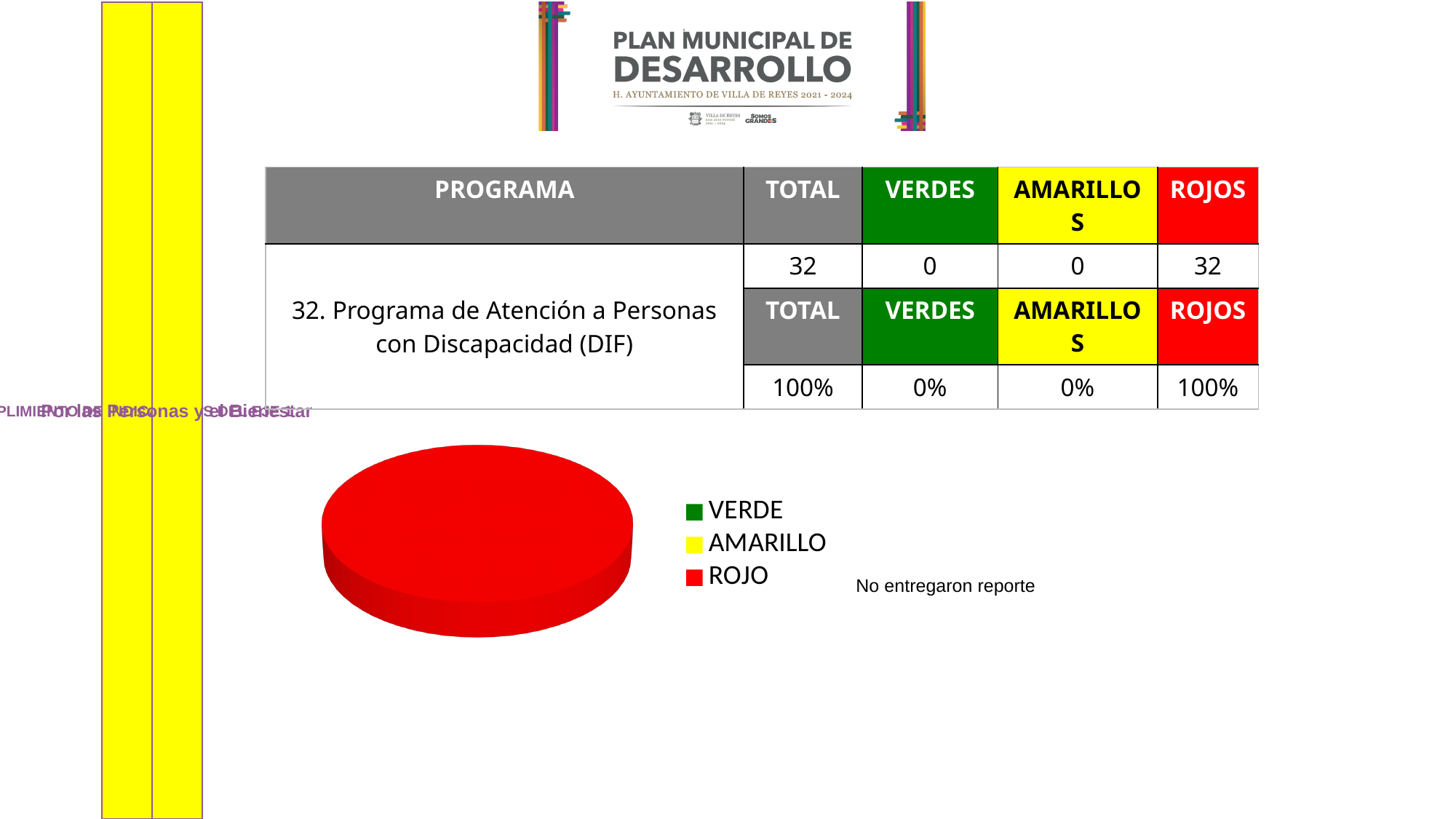
What share of the pie chart does ROJO represent? 100% What are the three legend entries of the pie chart, in order? VERDE, AMARILLO, ROJO Which category takes up the largest share of the pie chart? ROJO What kind of chart is shown on the slide? pie chart What share of the pie chart does VERDE represent? 0% How many ROJOS does the table report for the program shown in the pie chart? 32 How many entries does the pie chart's legend list? 3 What is the difference between the number of ROJOS and the number of VERDES shown in the table? 32 Which is larger in the pie chart, the ROJO slice or the VERDE slice? ROJO What share of the pie chart does AMARILLO represent? 0% What colour is the slice that fills the pie chart? red